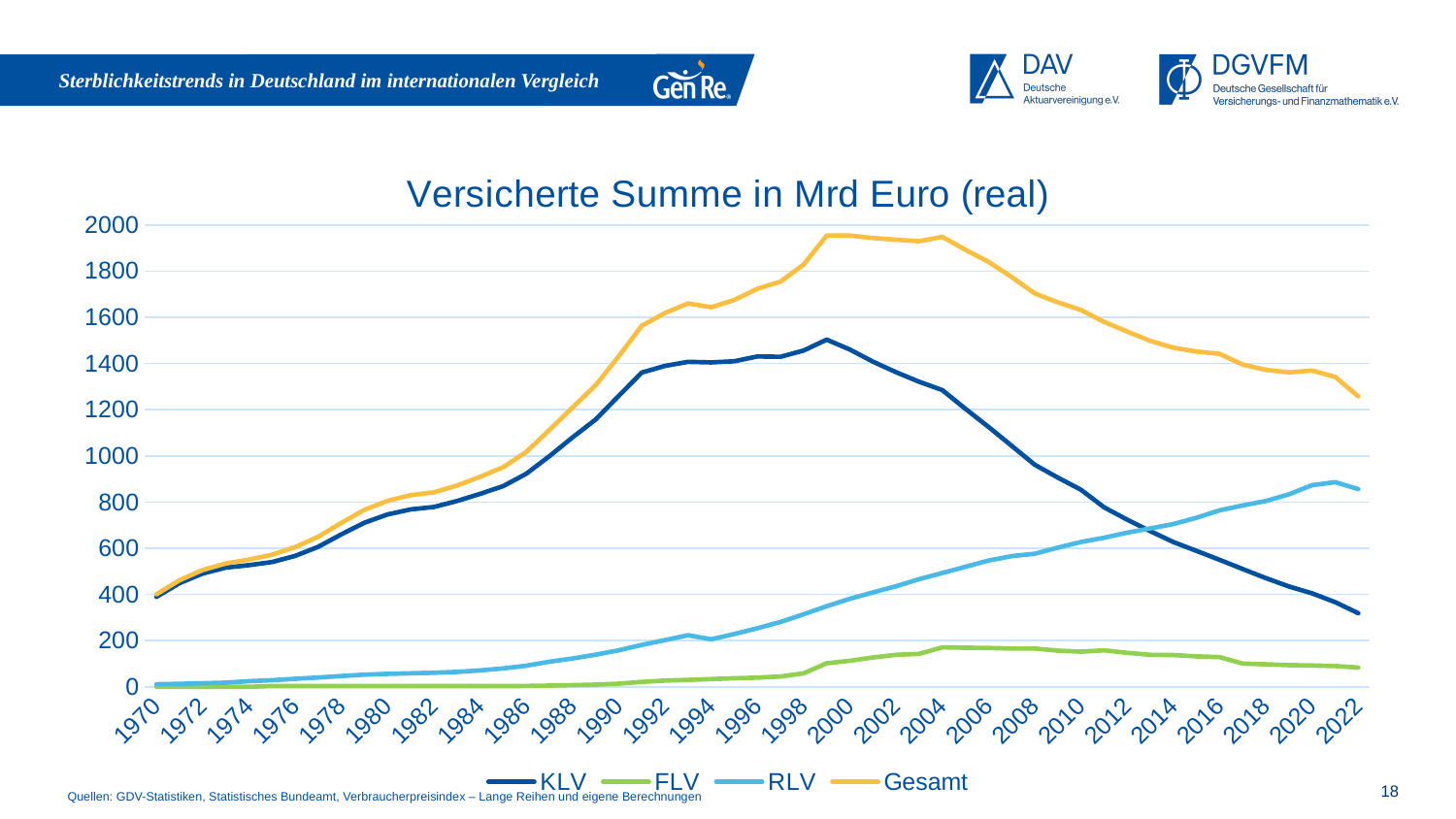
Does the KLV series rise or fall between 2000 and 2022? fall Which series are listed in the legend? KLV, FLV, RLV, Gesamt Is the value for KLV in 2022 greater or less than 400? less Which is larger in 2022, KLV or RLV? RLV How many series does the legend list? 4 Which is larger in 2000, KLV or RLV? KLV Is the value for RLV in 2022 greater or less than 800? greater Which series has the lowest value in 2022? FLV Is the value for FLV in 2022 greater or less than 200? less What is the title of the chart? Versicherte Summe in Mrd Euro (real) What kind of chart is shown on the slide? line chart